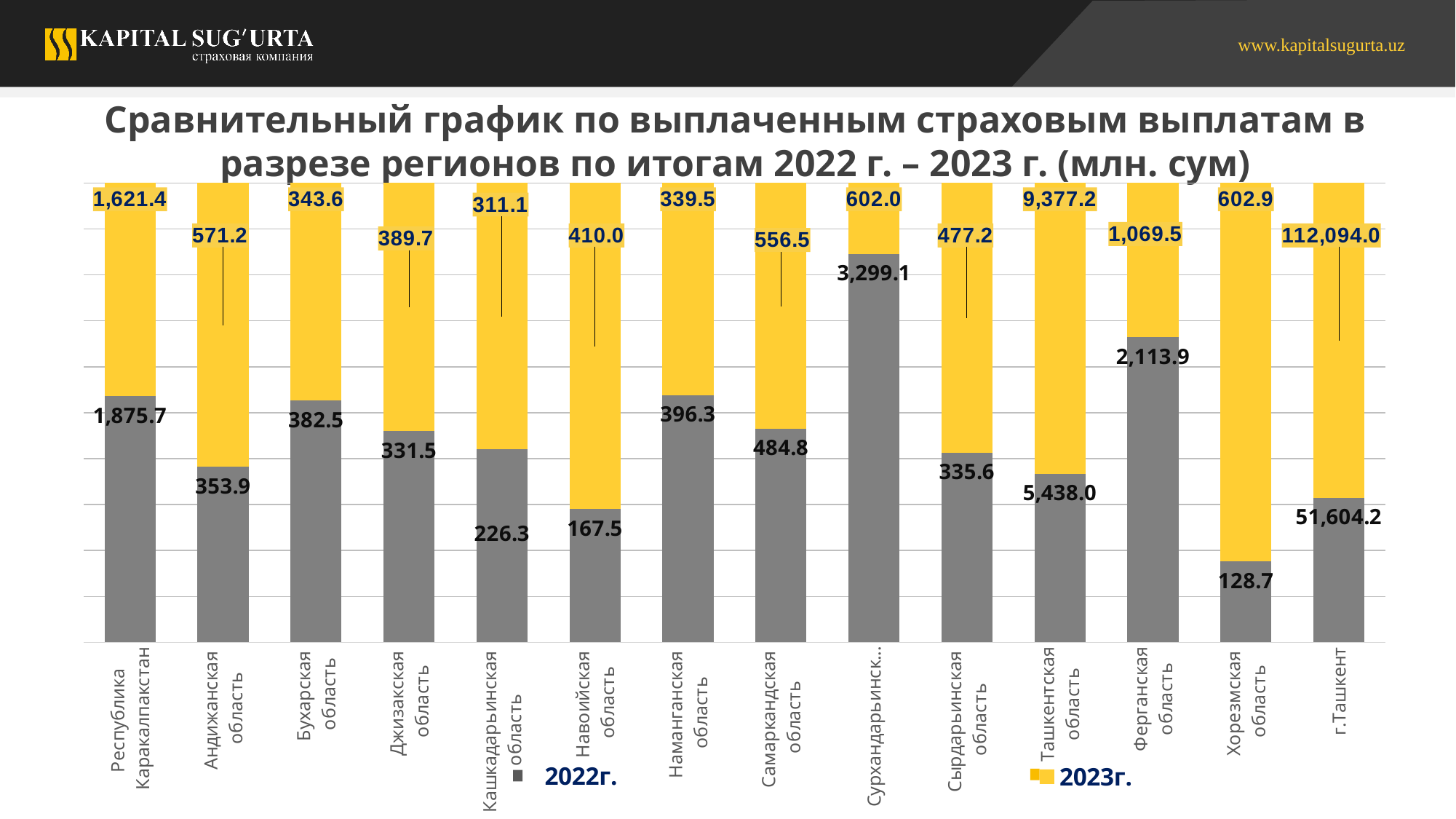
Which region has the highest 2023г. value? г.Ташкент Which region has the lowest 2022г. value? Хорезмская область For Ферганская область, which is larger: the 2022г. value or the 2023г. value? 2022г. How many series does the legend list? 2 What is the difference between the 2023г. and 2022г. values for Ташкентская область? 3,939.2 How many regions (categories) are shown on the x axis? 14 What is the 2022г. value for Навоийская область? 167.5 Which colour represents the 2023г. series in the chart? yellow For Андижанская область, which is larger: the 2022г. value or the 2023г. value? 2023г. What kind of chart is shown on the slide? bar chart What is the 2023г. value for Ташкентская область? 9,377.2 What is the 2023г. value for Хорезмская область? 602.9